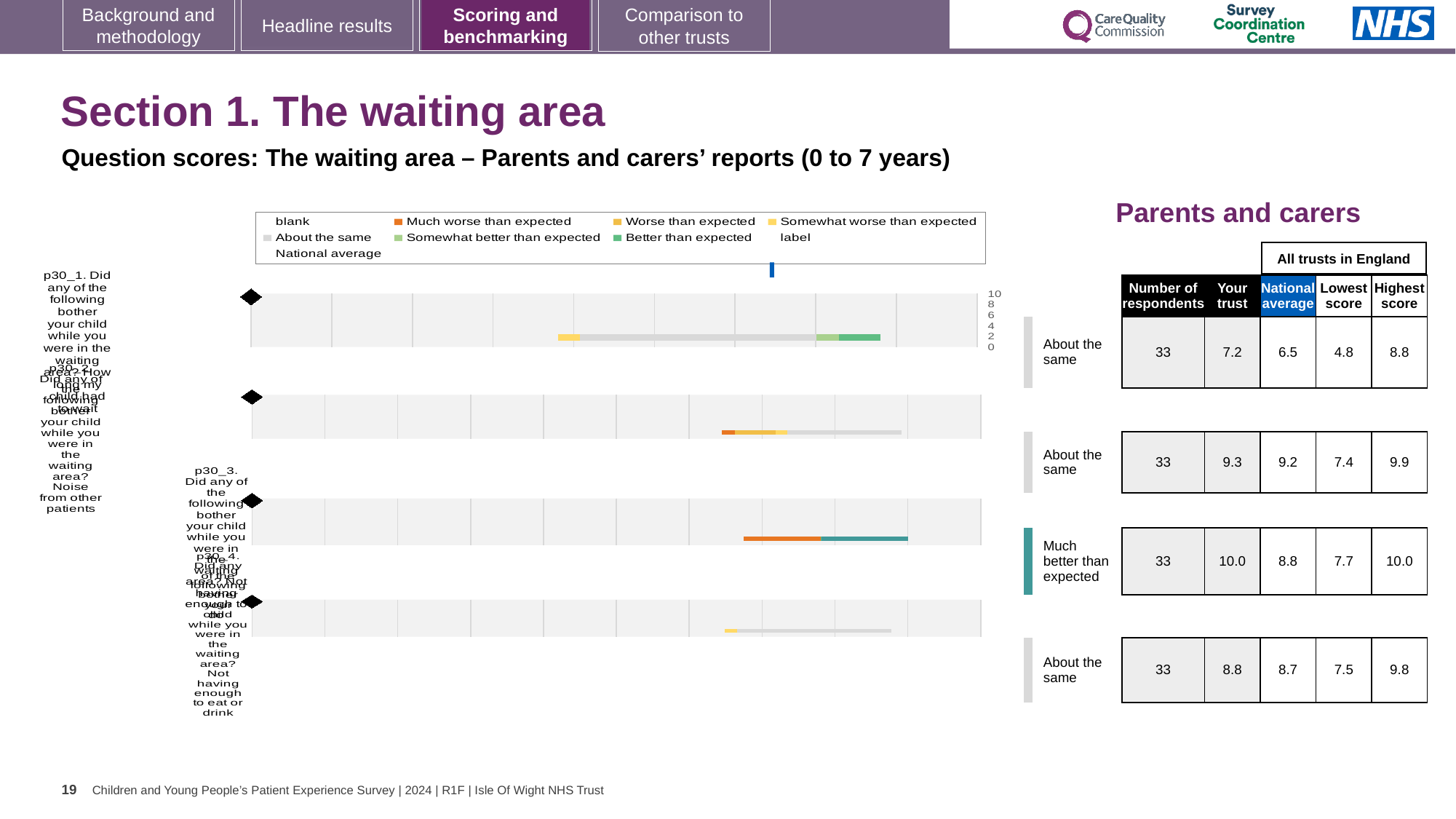
What is the difference between the 'Your trust' score and the national average for p30_1 in the table beside the chart? 0.7 In the table beside the chart, what is the national average for p30_1 (How long my child had to wait)? 6.5 How many questions (categories) are plotted in the chart? 4 In the table beside the chart, what is the highest score across all trusts in England for p30_4 (Not having enough to eat or drink)? 9.8 Which benchmark category is shown for p30_3 (Not having enough to do)? Much better than expected Is the 'Your trust' score for p30_2 larger or smaller than the national average for p30_2 in the table beside the chart? larger In the table beside the chart, what is the lowest score across all trusts in England for p30_2 (Noise from other patients)? 7.4 What kind of chart is shown on the slide? bar chart Which question has the lowest 'Your trust' score in the table beside the chart? p30_1 (How long my child had to wait) Which question has the highest 'Your trust' score in the table beside the chart? p30_3 (Not having enough to do) How many respondents are listed for each question in the table beside the chart? 33 In the table beside the chart, what is the 'Your trust' score for p30_3 (Not having enough to do)? 10.0